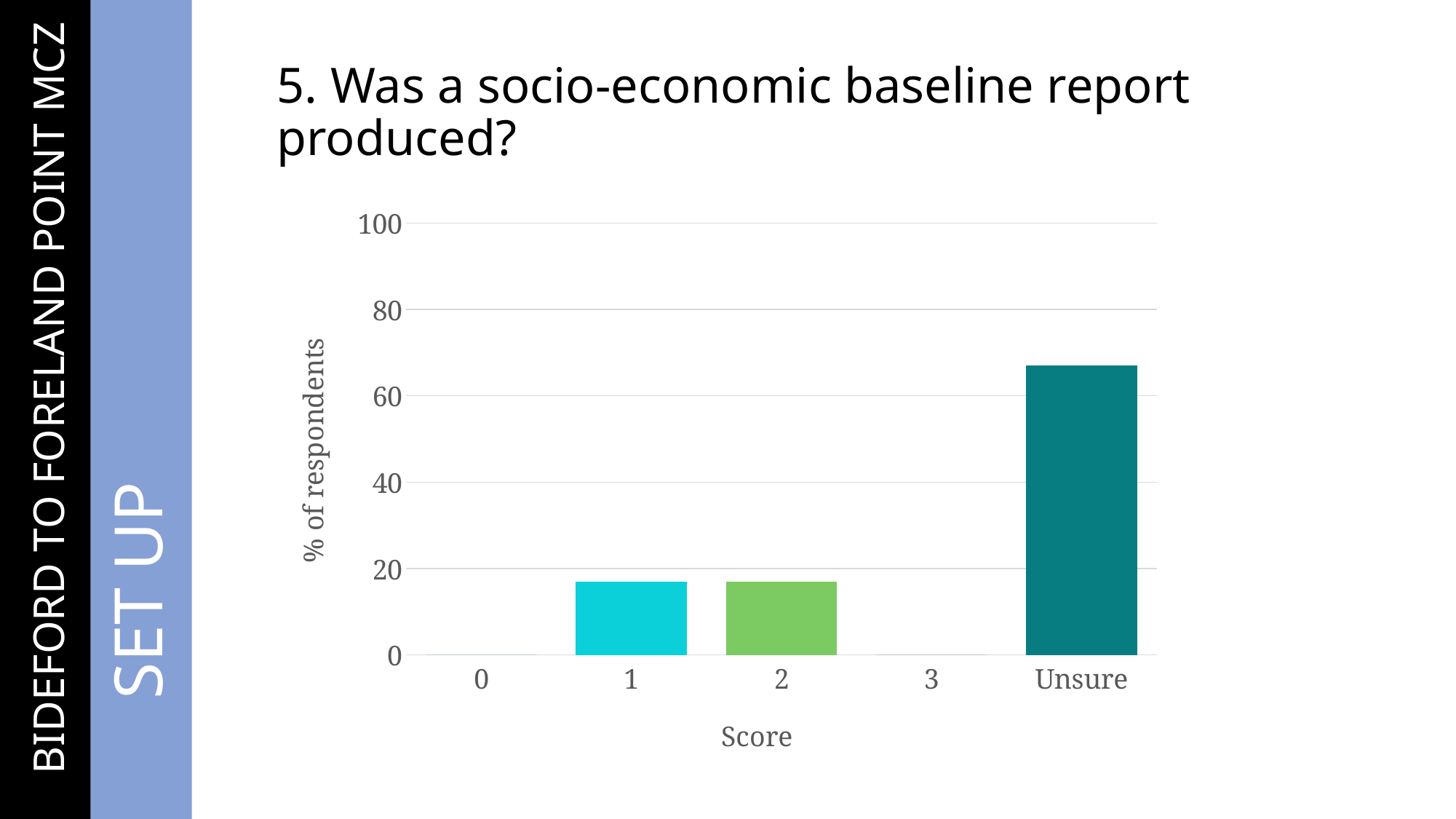
Which category has the highest value in the chart? Unsure What is the label of the y axis of the chart? % of respondents Which is larger, the value for Unsure or the value for score 1? Unsure Is the value for score 1 greater or less than 20? less Is the value for Unsure greater or less than 60? greater How many categories are shown on the x axis of the chart? 5 Is the value for score 2 greater or less than 20? less Which is larger, the value for score 2 or the value for score 3? score 2 What kind of chart is shown on the slide? bar chart What is the label of the x axis of the chart? Score